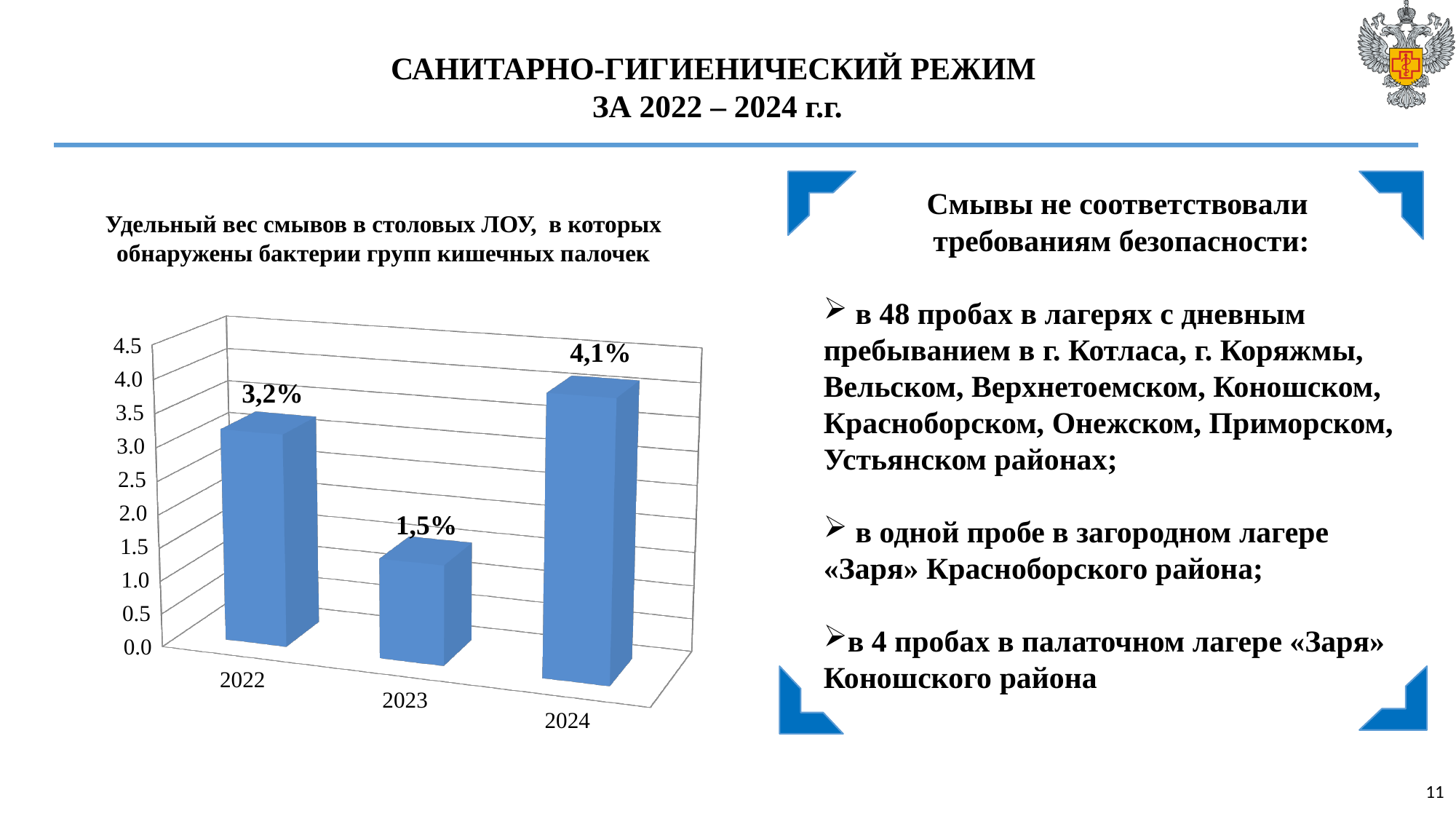
What is the difference between the values for 2024 and 2022? 0,9% Which year has the lowest value? 2023 Which year has the highest value? 2024 What is the value shown for 2022? 3,2% What kind of chart is shown on the slide? bar chart Which is larger, the value for 2022 or the value for 2023? 2022 What is the difference between the values for 2022 and 2023? 1,7% What is the value shown for 2023? 1,5% What is the value shown for 2024? 4,1% Is the value for 2024 greater or less than 4.0? greater Does the value rise or fall from 2023 to 2024? rise How many years are shown on the chart? 3